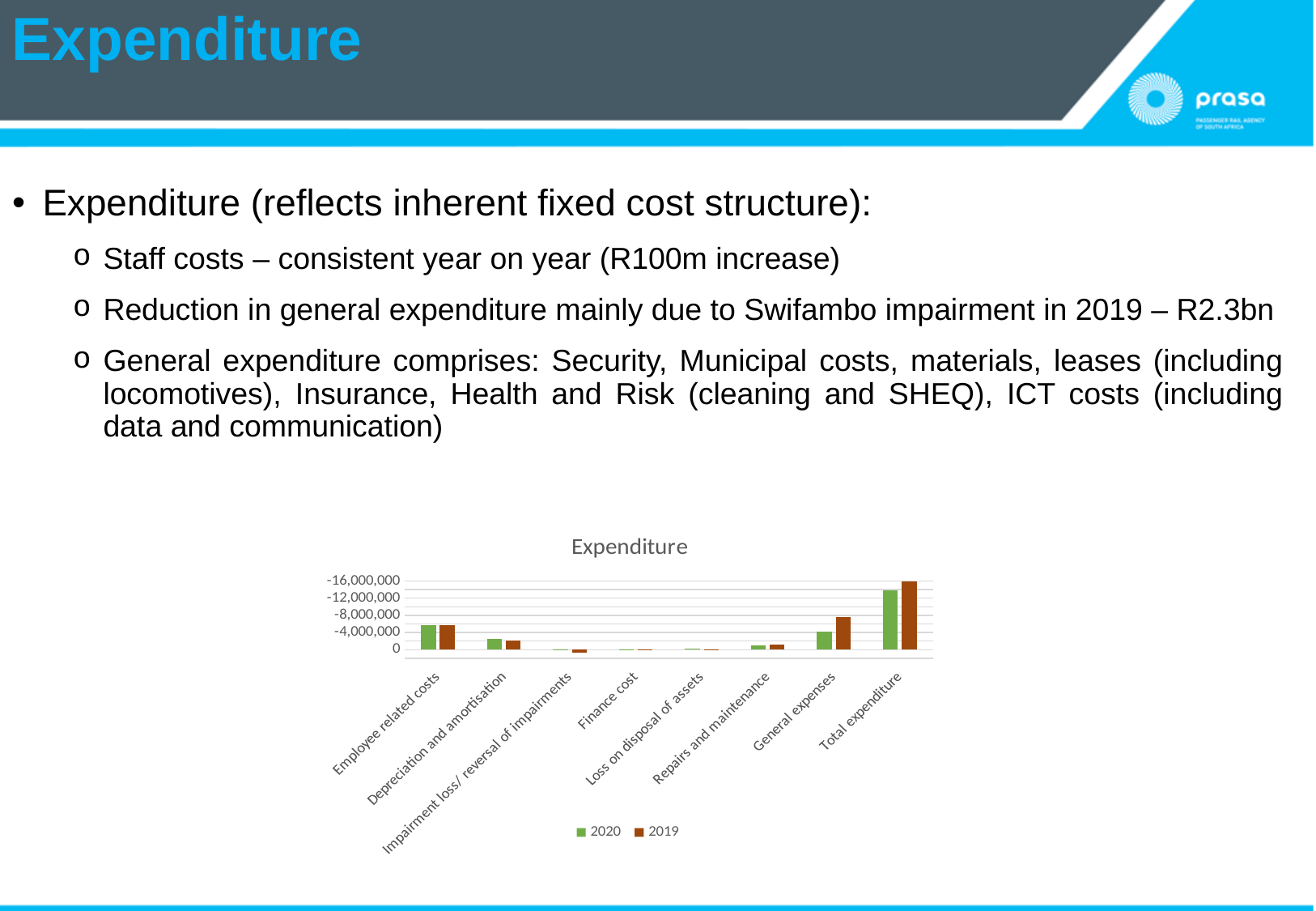
Is the 2020 value for Employee related costs greater or less than -8,000,000? greater What is the title of the chart? Expenditure For Total expenditure, which year has the larger bar, 2020 or 2019? 2019 Is the 2019 value for General expenses greater or less than -4,000,000? less Which years are listed in the chart's legend? 2020 and 2019 Is the 2020 value for Total expenditure greater or less than -12,000,000? less Which category has the largest bars in the chart? Total expenditure What type of chart is shown on the slide? Bar chart How many series does the chart's legend list? 2 How many expenditure categories are shown on the x axis of the chart? 8 For General expenses, which year has the larger bar, 2020 or 2019? 2019 Which category has the smallest bars in the chart? Finance cost